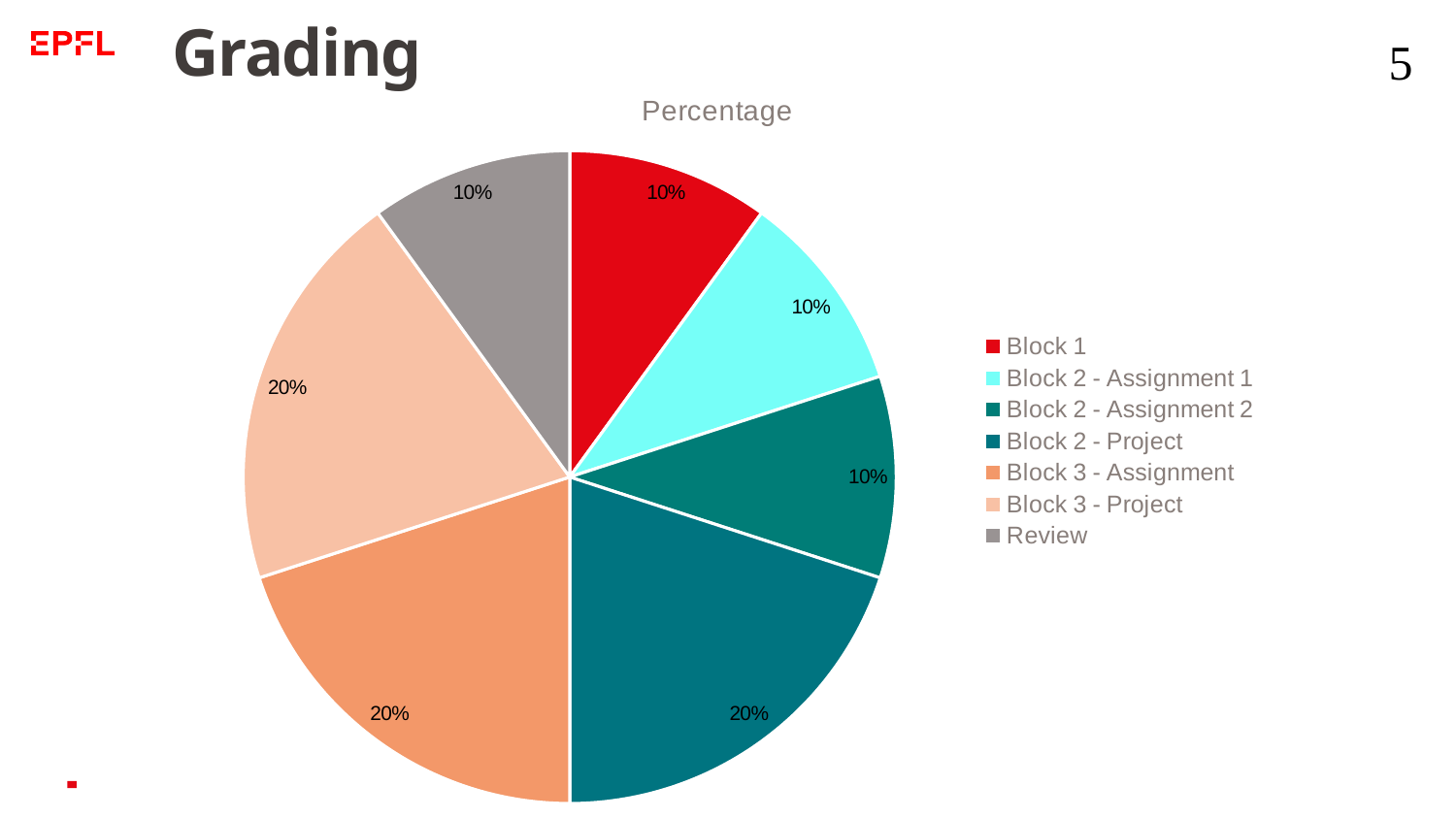
What percentage is shown for Block 3 - Assignment? 20% Which legend entry is shown in grey? Review What percentage is shown for Block 1? 10% What is the combined percentage of Block 2 - Assignment 1, Block 2 - Assignment 2 and Block 2 - Project? 40% How many slices are labelled 20%? 3 What percentage is shown for Block 2 - Project? 20% What kind of chart is shown on the slide? pie chart How many slices does the pie chart have? 7 Which is larger, the slice for Block 3 - Project or the slice for Block 2 - Assignment 1? Block 3 - Project What percentage is shown for Review? 10% What is the difference between the percentage for Block 2 - Project and the percentage for Block 2 - Assignment 2? 10% What is the title of the chart? Percentage